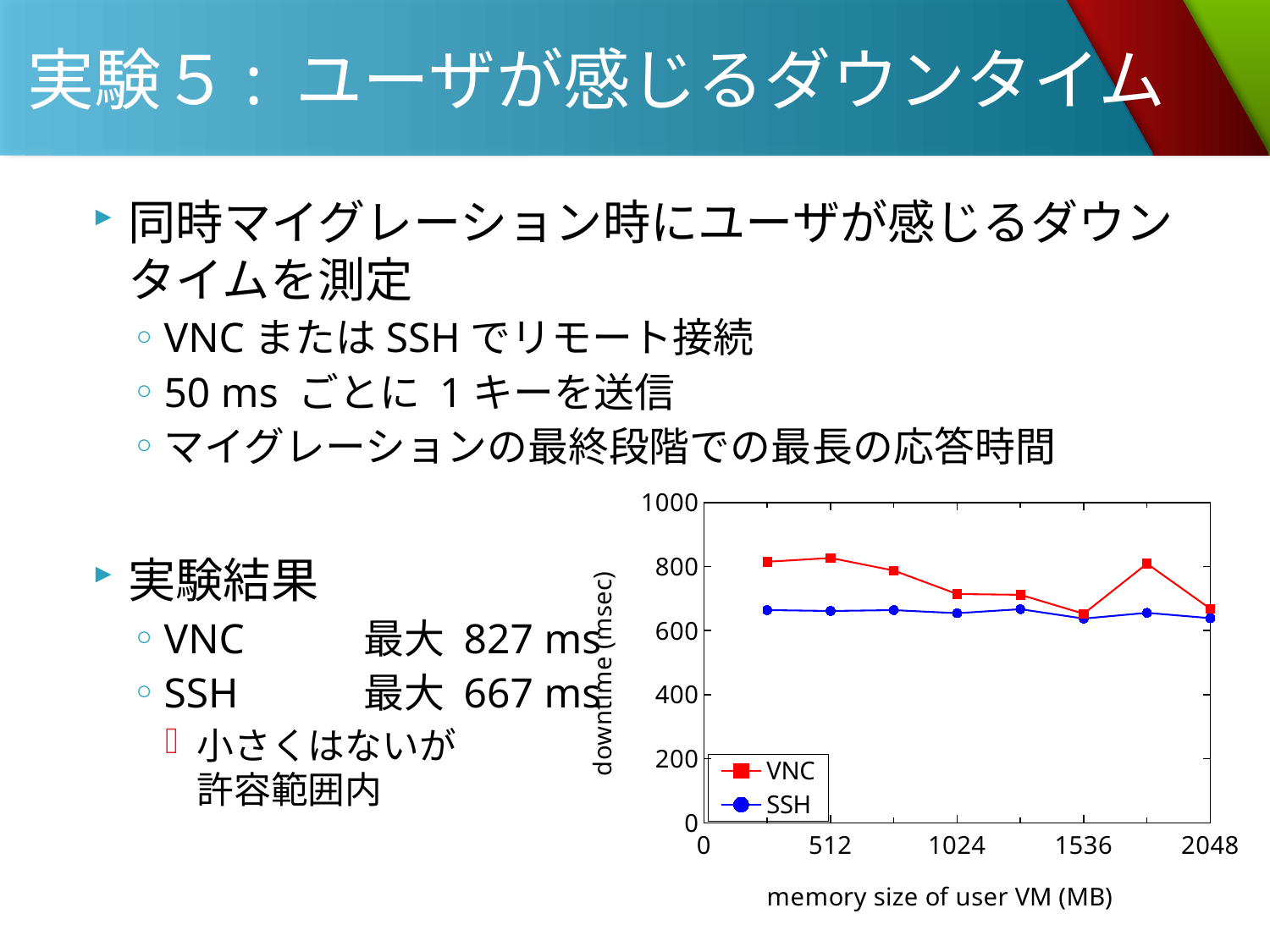
What is the label of the y axis of the chart? downtime (msec) Is the VNC downtime at a memory size of 1024 MB greater or less than 800 msec? less At a memory size of 512 MB, which series has the larger downtime, VNC or SSH? VNC What kind of chart is shown on the slide? line chart How many series does the chart legend list? 2 Does the VNC downtime generally rise or fall as memory size increases from 512 MB to 1536 MB? fall Which series shows the higher downtime values overall, VNC or SSH? VNC Which colour is used for the SSH series in the chart? blue Is the SSH downtime at a memory size of 512 MB greater or less than 600 msec? greater How many data points are plotted for the VNC series? 8 Is the VNC downtime at a memory size of 512 MB greater or less than 800 msec? greater